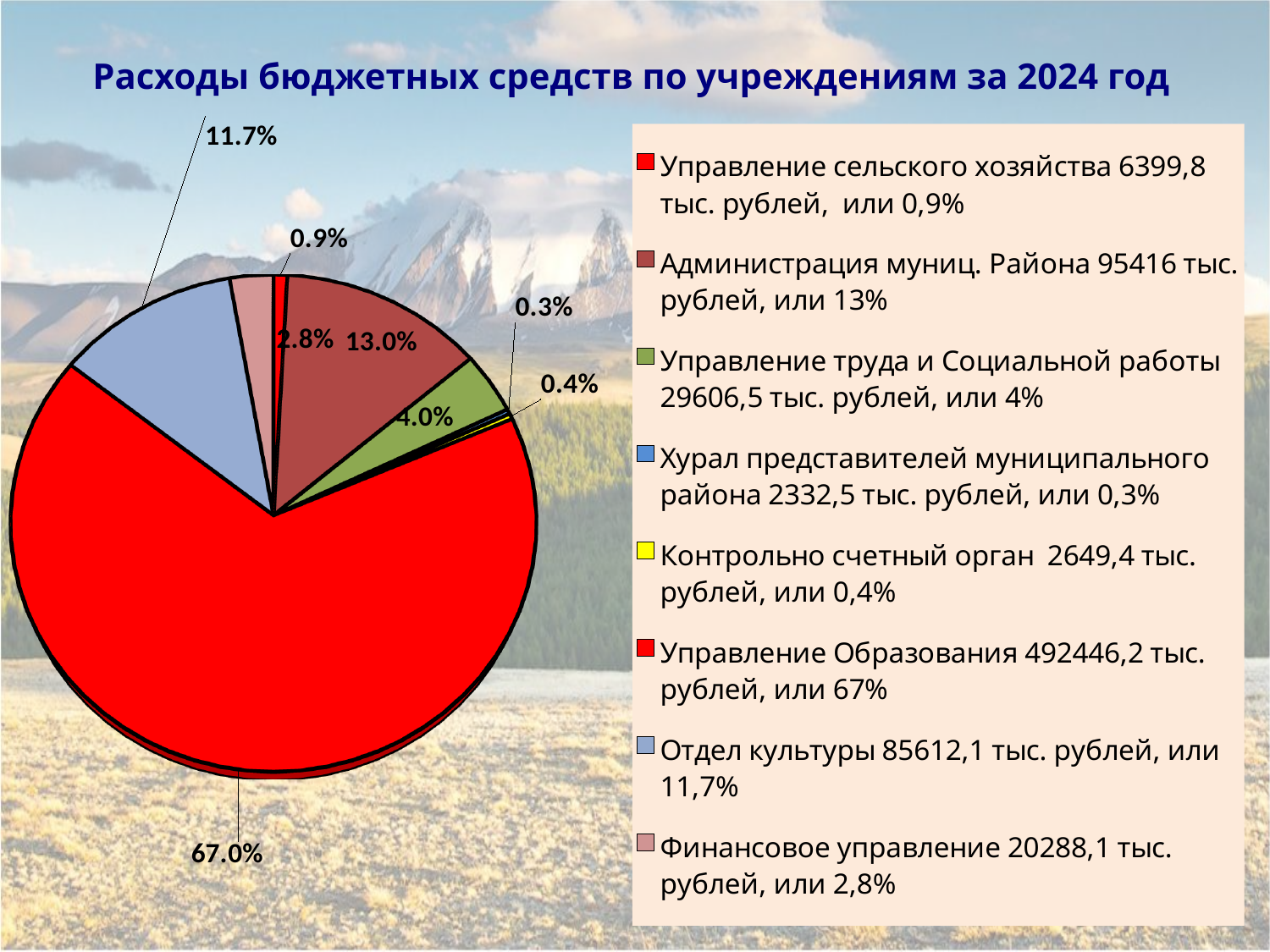
What share of budget expenditures does Отдел культуры account for? 11.7% What colour represents Контрольно счетный орган in the pie chart? Yellow What kind of chart is shown on the slide? Pie chart Which has the larger share: Управление труда и Социальной работы or Финансовое управление? Управление труда и Социальной работы What share of budget expenditures does Управление сельского хозяйства account for? 0.9% Which institution has the largest share of budget expenditures in the pie chart? Управление Образования What share of budget expenditures does Администрация муниц. Района account for? 13.0% According to the legend, how much did Управление Образования spend in thousand rubles? 492446,2 тыс. рублей By how many percentage points does the share of Управление Образования exceed the share of Администрация муниц. Района? 54.0 percentage points What is the title of the chart? Расходы бюджетных средств по учреждениям за 2024 год How many slices does the pie chart have? 8 Which institution has the smallest share of budget expenditures in the pie chart? Хурал представителей муниципального района